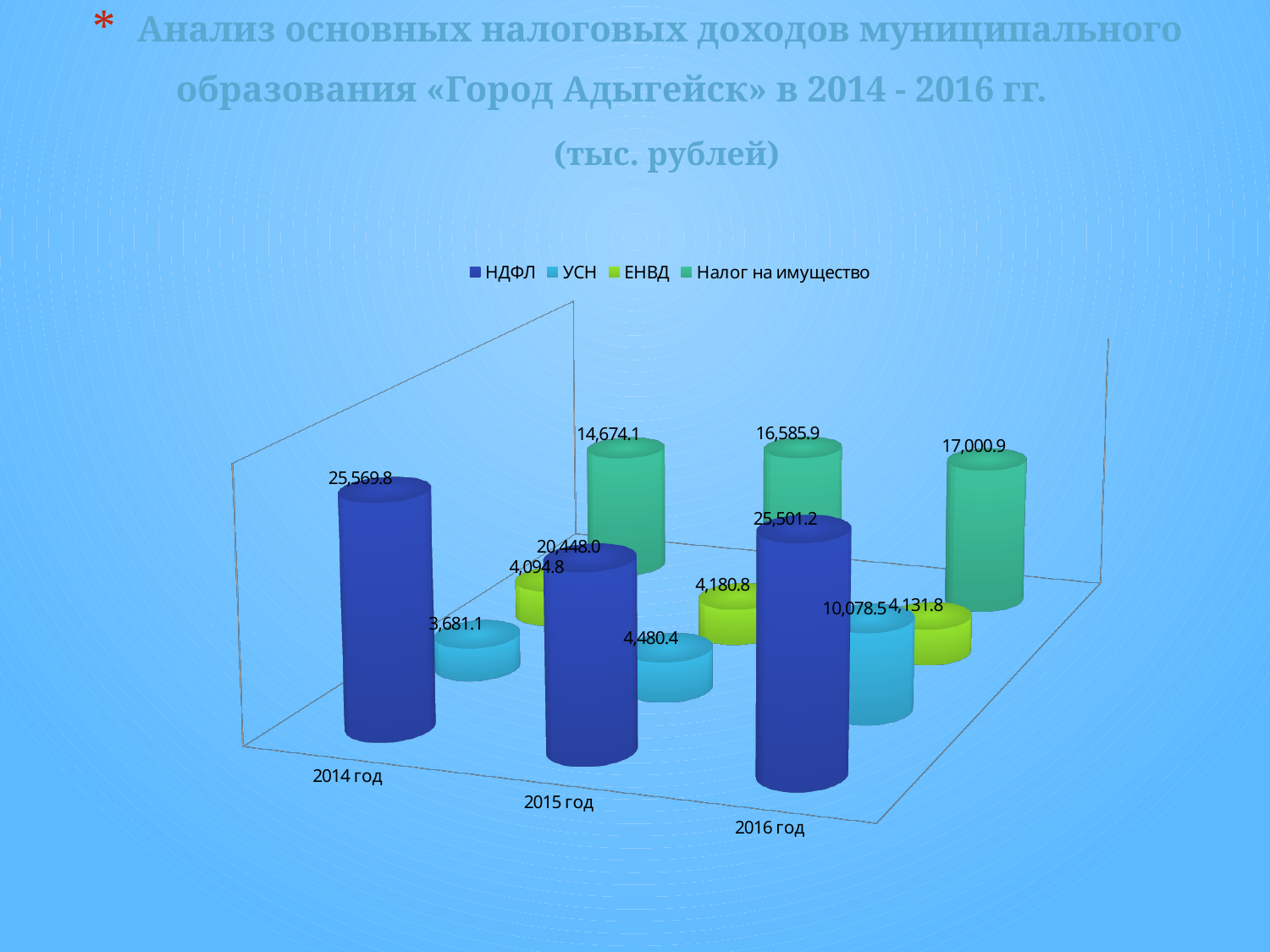
What kind of chart is shown on the slide? Bar chart Which is larger, the ЕНВД value for 2015 год or for 2016 год? 2015 год What is the value of НДФЛ for 2014 год? 25,569.8 How many series does the legend list? 4 In which year is the value of НДФЛ the highest? 2014 год What is the value of Налог на имущество for 2016 год? 17,000.9 Does the value of Налог на имущество rise or fall from 2014 год to 2016 год? Rises What is the value of УСН for 2016 год? 10,078.5 How many years (categories) are shown on the x axis? 3 What is the difference between the Налог на имущество values for 2016 год and 2014 год? 2,326.8 What is the difference between the УСН values for 2016 год and 2015 год? 5,598.1 In which year is the value of УСН the lowest? 2014 год